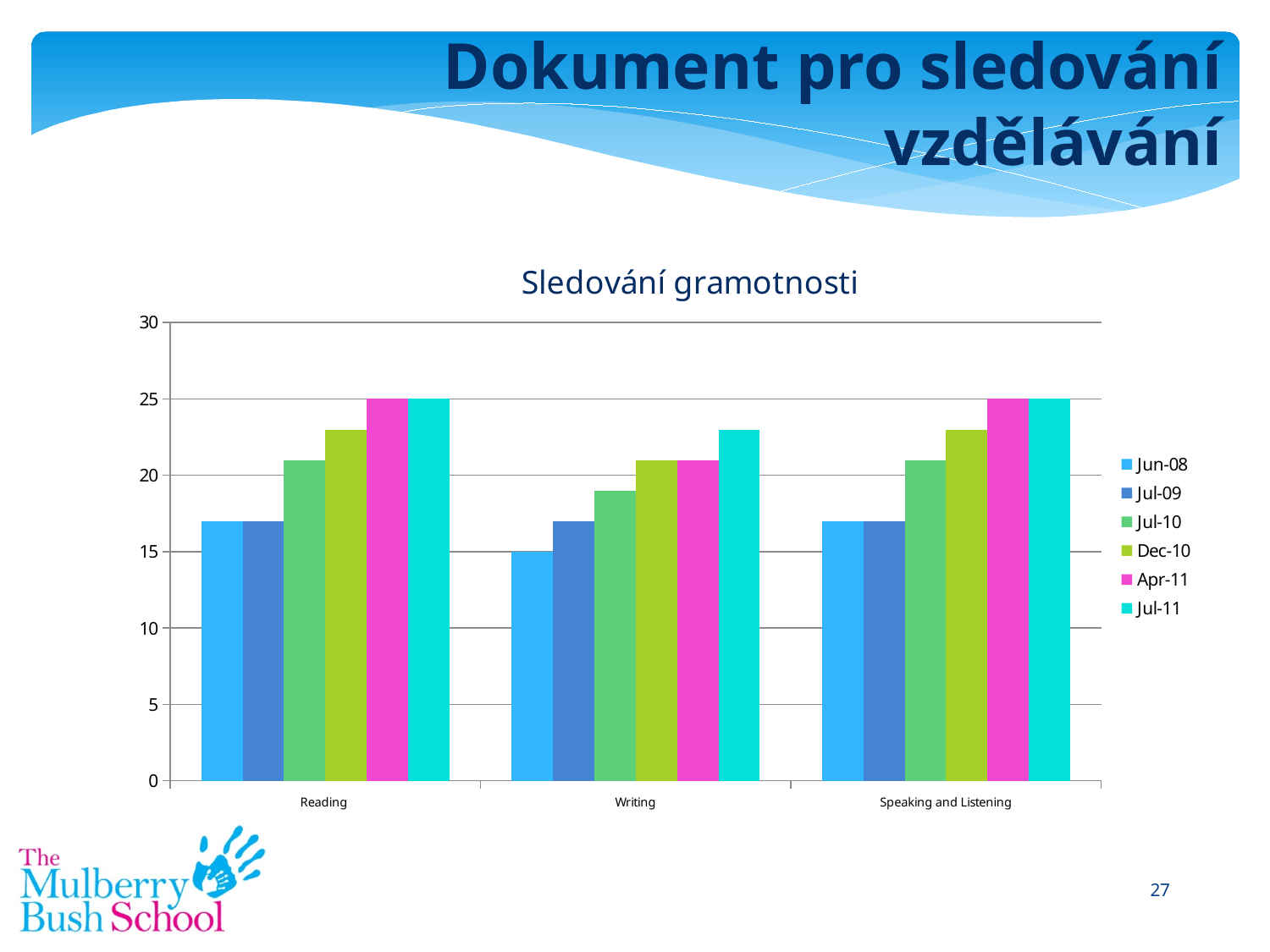
Is the value for Dec-10 in the Reading category greater or less than 20? greater Which is larger in the Writing category, the value for Jul-09 or the value for Jul-11? Jul-11 What is the value for Jul-11 in the Reading category? 25 What is the value for Apr-11 in the Speaking and Listening category? 25 How many categories are shown on the x axis? 3 Within the Writing category, do the values rise or fall from Jun-08 to Jul-11? rise Is the value for Jul-10 in the Writing category greater or less than 20? less What is the title of the chart? Sledování gramotnosti How many series does the legend list? 6 What is the value for Jun-08 in the Writing category? 15 Which series has the lowest value in the Writing category? Jun-08 What type of chart is shown on the slide? bar chart